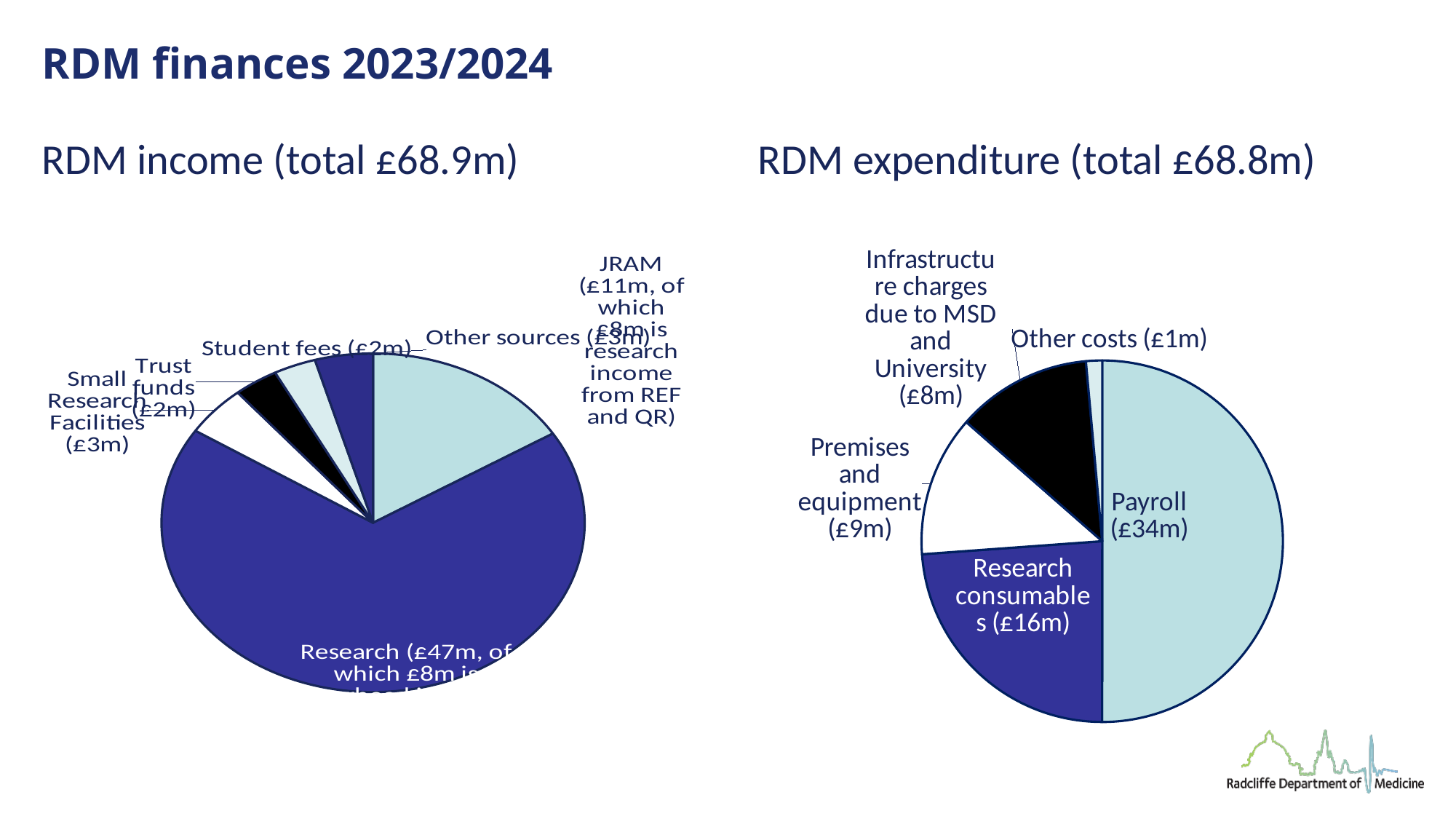
In the RDM expenditure pie chart, what is the difference between Payroll and Research consumables? £18m How many slices does the RDM income pie chart have? 6 In the RDM income pie chart, what is the difference between Research and JRAM? £36m In the RDM expenditure pie chart, which category has the smallest value? Other costs In the RDM expenditure pie chart, what is the value for Payroll? £34m In the RDM income pie chart, what is the value for Research? £47m What type of chart is used to show RDM expenditure? Pie chart In the RDM expenditure pie chart, which is larger, Premises and equipment or Infrastructure charges due to MSD and University? Premises and equipment In the RDM expenditure pie chart, what is the value for Premises and equipment? £9m In the RDM income pie chart, which category has the largest value? Research In the RDM income pie chart, what is the value for JRAM? £11m How many slices does the RDM expenditure pie chart have? 5